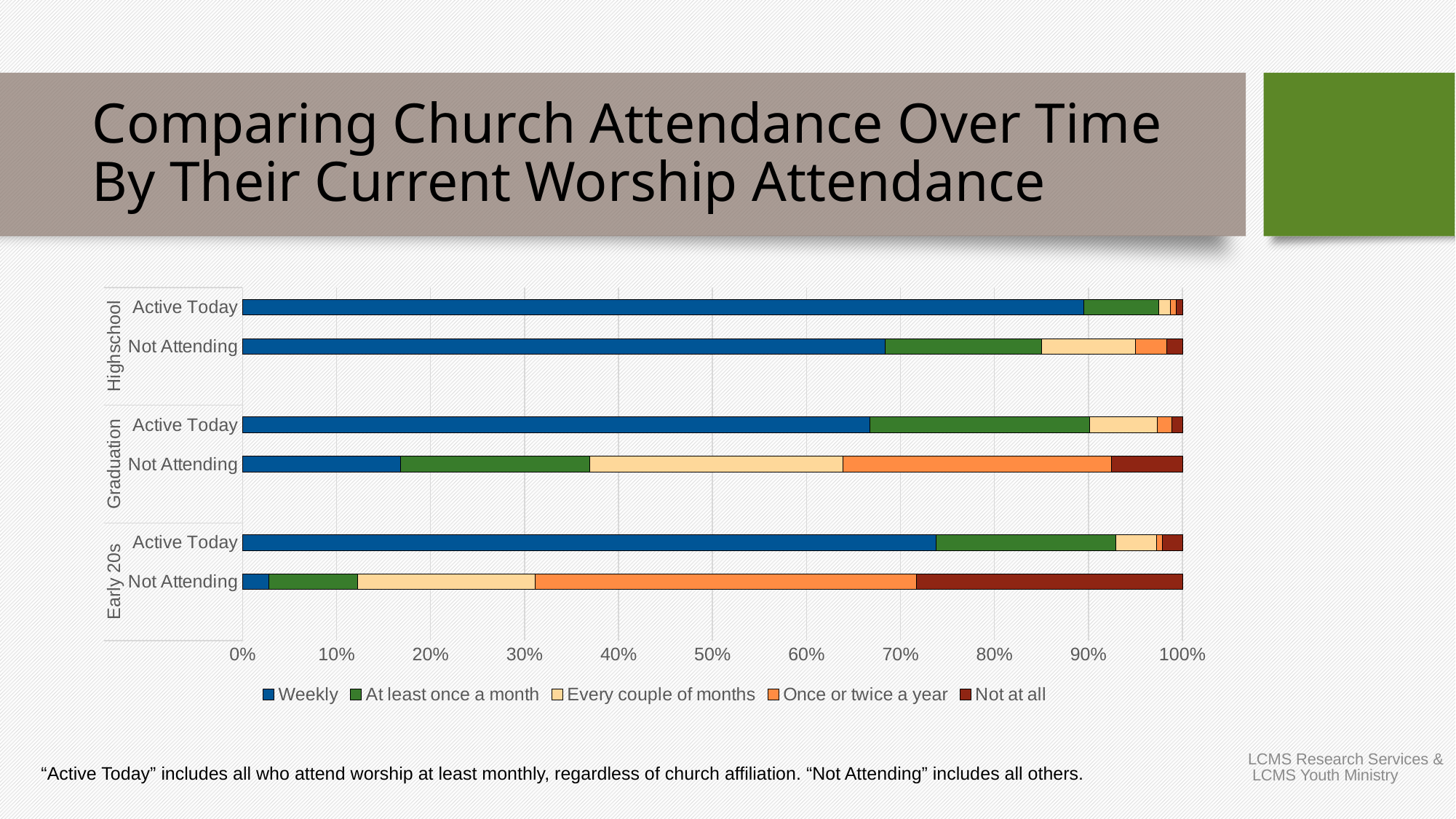
Which has a larger Weekly segment: Highschool Active Today or Early 20s Active Today? Highschool Active Today Which bar has the largest Weekly segment? Highschool Active Today Is the Weekly share for Highschool Active Today greater or less than 80%? greater Does the Weekly share for the Not Attending group rise or fall from Highschool to Graduation to Early 20s? Fall What kind of chart is shown on the slide? Stacked bar chart How many series does the legend list? 5 Is the Weekly share for Graduation Not Attending greater or less than 20%? less Which bar has the smallest Weekly segment? Early 20s Not Attending Which bar has the largest Not at all segment? Early 20s Not Attending How many bars are plotted in the chart? 6 Is the Weekly share for Early 20s Not Attending greater or less than 10%? less What is the total of each stacked bar? 100%